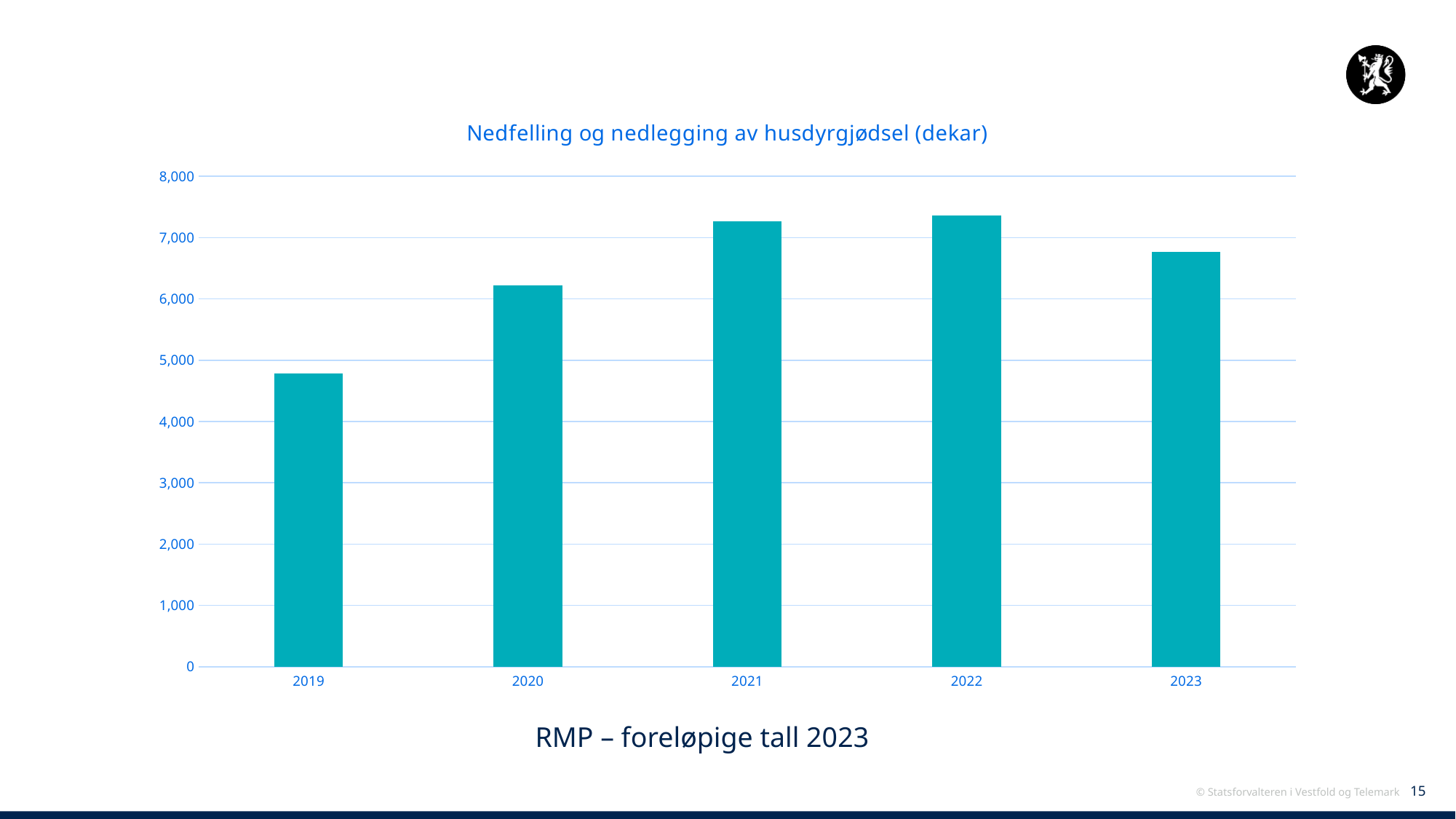
Is the value for 2022 greater or less than 8,000? less Is the value for 2019 greater or less than 5,000? less Is the value for 2020 greater or less than 6,000? greater What is the title of the chart? Nedfelling og nedlegging av husdyrgjødsel (dekar) Which is larger, the value for 2021 or the value for 2023? 2021 How many years are shown on the x axis of the chart? 5 Which year has the lowest value in the chart? 2019 Does the value rise or fall from 2022 to 2023? fall What kind of chart is shown on the slide? bar chart Which is larger, the value for 2019 or the value for 2020? 2020